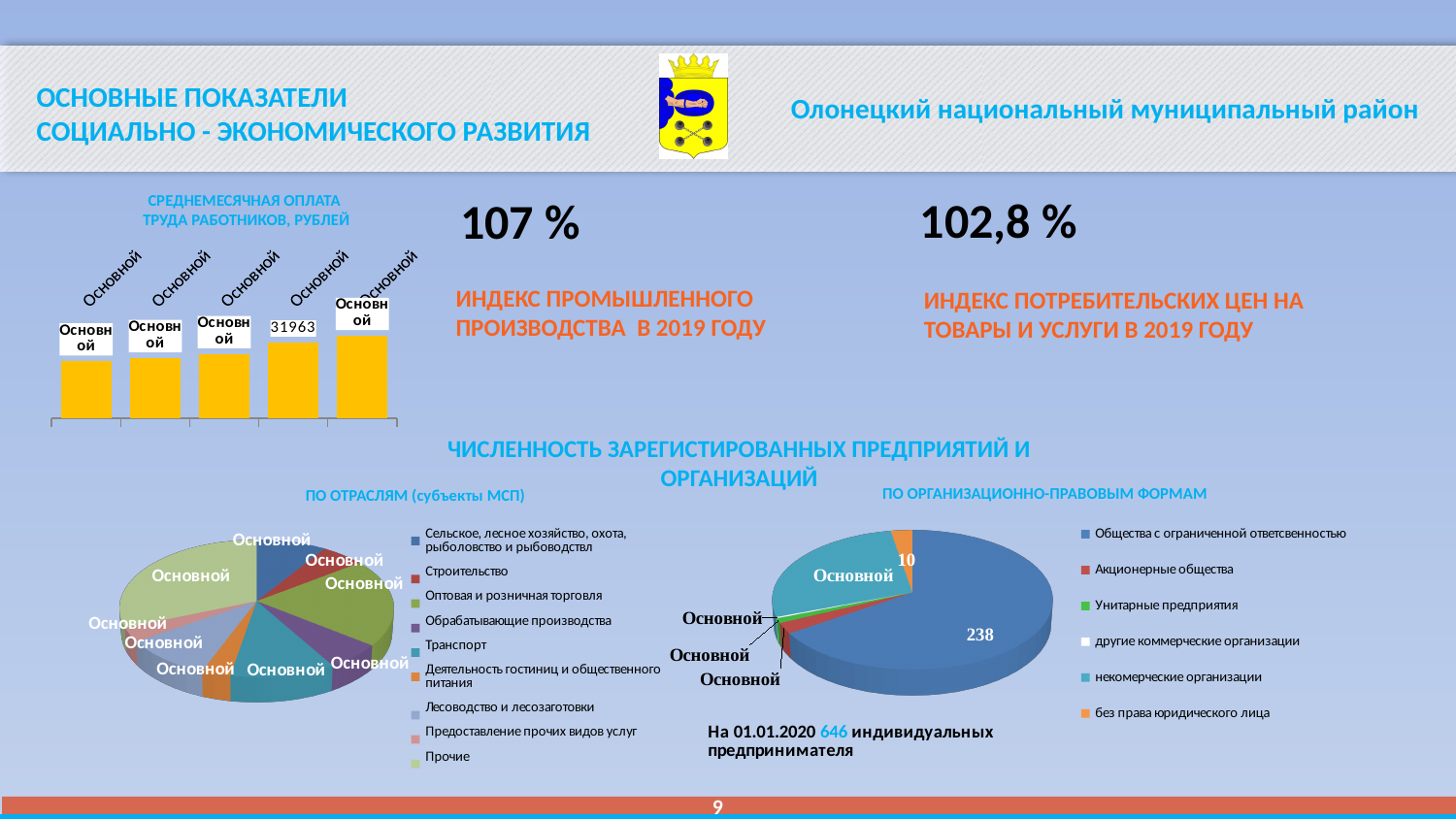
How many entries does the legend of the bottom-left chart "ПО ОТРАСЛЯМ (субъекты МСП)" list? 9 How many entries does the legend of the bottom-right chart "ПО ОРГАНИЗАЦИОННО-ПРАВОВЫМ ФОРМАМ" list? 6 In the bottom-right chart "ПО ОРГАНИЗАЦИОННО-ПРАВОВЫМ ФОРМАМ", what value is printed on the slice for Общества с ограниченной ответственностью? 238 What colour is the largest slice in the bottom-right chart "ПО ОРГАНИЗАЦИОННО-ПРАВОВЫМ ФОРМАМ"? blue In the bottom-right chart "ПО ОРГАНИЗАЦИОННО-ПРАВОВЫМ ФОРМАМ", is the value for Общества с ограниченной ответственностью greater or less than 200? greater In the top-left bar chart, what numeric data label is printed on the fourth bar from the left? 31963 How many bars are plotted in the top-left chart "СРЕДНЕМЕСЯЧНАЯ ОПЛАТА ТРУДА РАБОТНИКОВ, РУБЛЕЙ"? 5 What kind of chart is the top-left chart titled "СРЕДНЕМЕСЯЧНАЯ ОПЛАТА ТРУДА РАБОТНИКОВ, РУБЛЕЙ"? bar chart What is the first entry in the legend of the bottom-left chart "ПО ОТРАСЛЯМ (субъекты МСП)"? Сельское, лесное хозяйство, охота, рыболовство и рыбоводствл In the bottom-right chart "ПО ОРГАНИЗАЦИОННО-ПРАВОВЫМ ФОРМАМ", which category has the largest slice? Общества с ограниченной ответственностью What kind of chart is the bottom-right chart "ПО ОРГАНИЗАЦИОННО-ПРАВОВЫМ ФОРМАМ"? pie chart What kind of chart is the bottom-left chart "ПО ОТРАСЛЯМ (субъекты МСП)"? pie chart